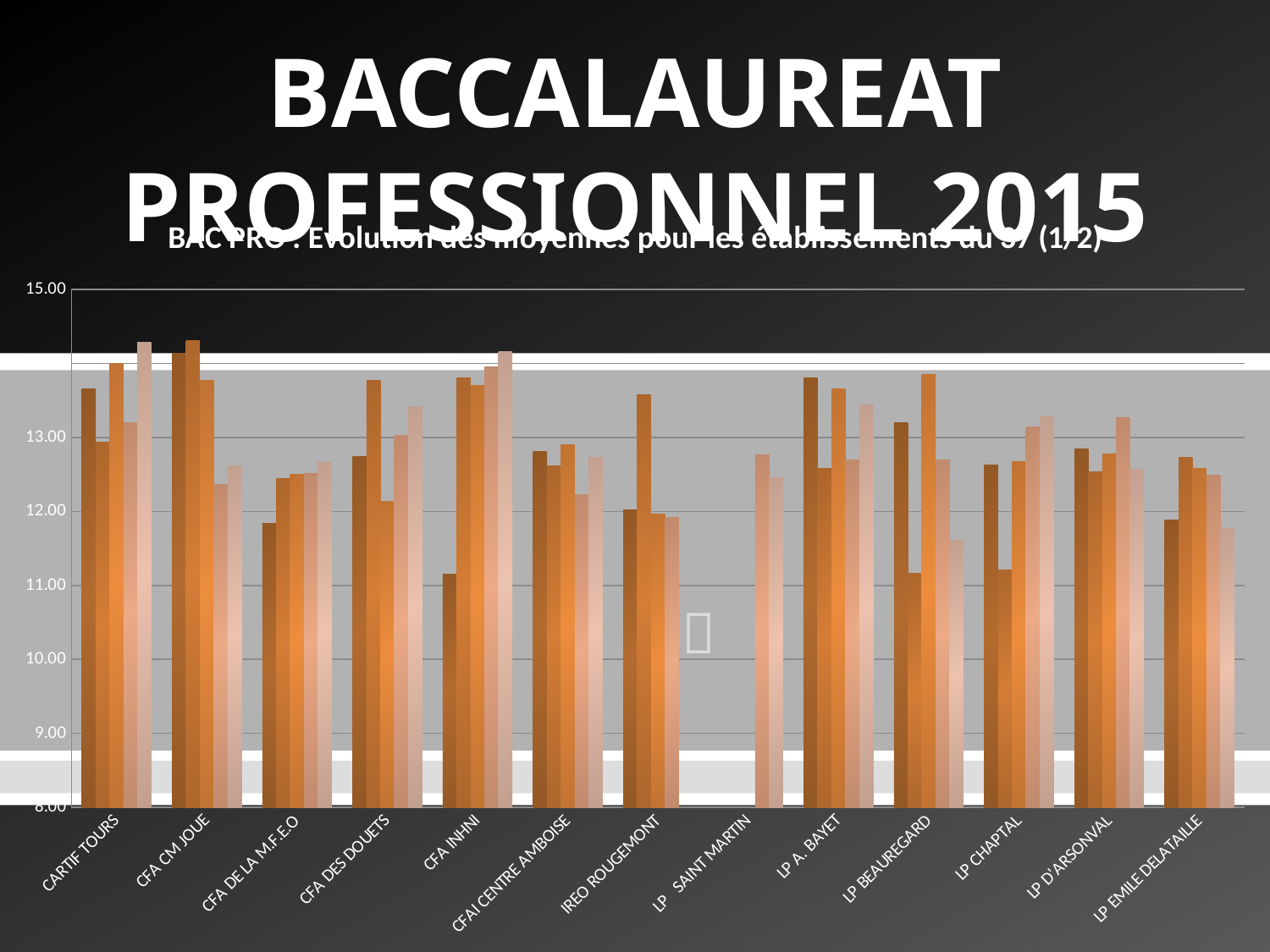
Is the value of the first bar for LP BEAUREGARD greater or less than 13.00? greater Is the value of the second bar for IREO ROUGEMONT greater or less than 13.00? greater Is the value of the first bar for CFA DE LA M.F.E.O greater or less than 12.00? less How many establishments (categories) are shown on the x axis of the chart? 13 What kind of chart is shown on the slide? bar chart What is the highest value shown on the chart's vertical axis? 15.00 What is the title of the chart? BAC PRO : Evolution des moyennes pour les établissements du 37 (1/2)